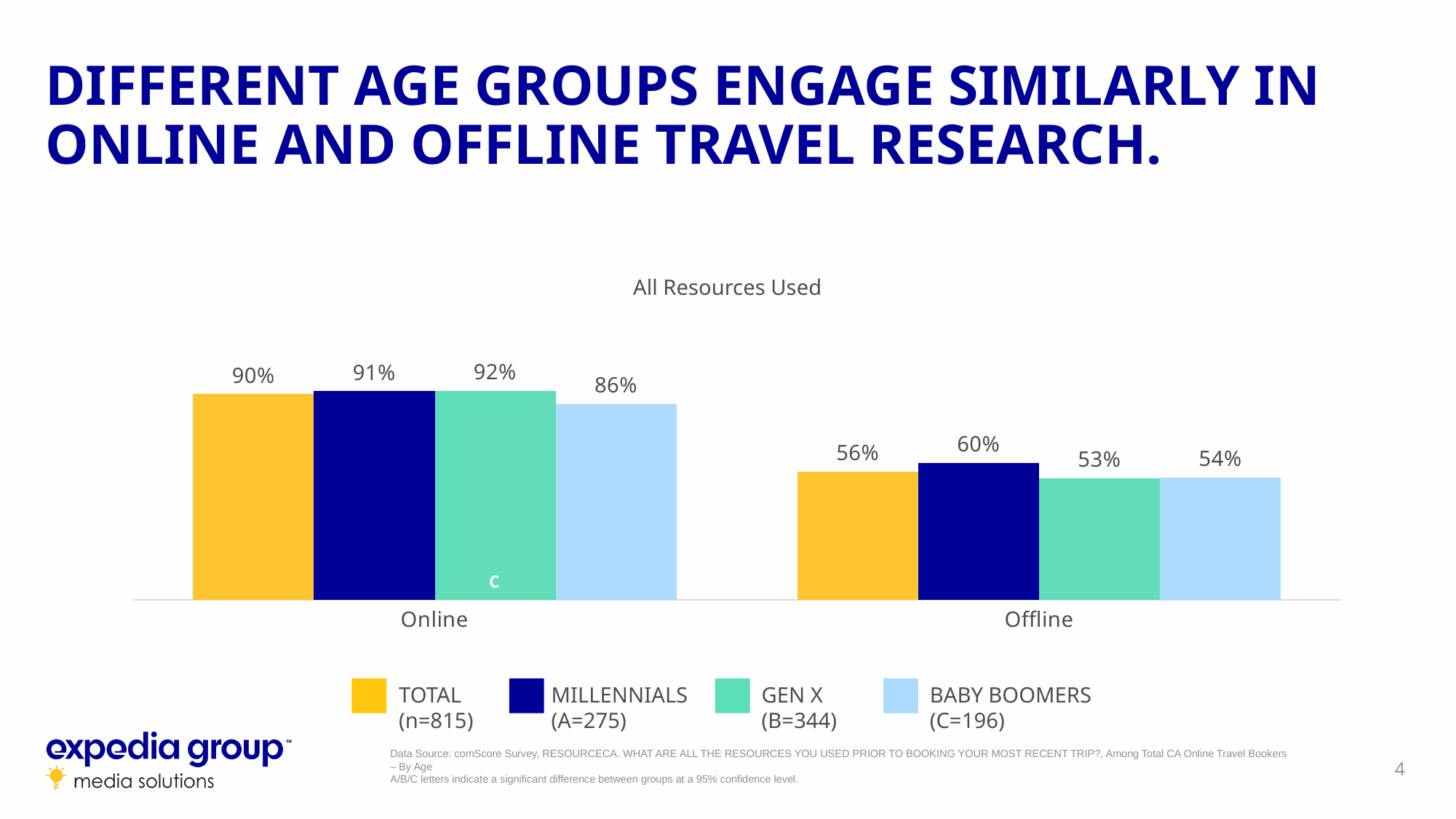
What is the value for Millennials in the Offline category? 60% What is the difference between the Gen X value for Online and the Gen X value for Offline? 39% Which is larger: the Total value for Online or the Total value for Offline? Online What kind of chart is shown on the slide? Bar chart How many categories are shown on the x axis? 2 Which series has the lowest value in the Online category? Baby Boomers Which series has the highest value in the Offline category? Millennials What is the value for Total in the Online category? 90% What is the value for Gen X in the Online category? 92% What is the value for Baby Boomers in the Offline category? 54% How many series does the legend list? 4 What is the title of the chart? All Resources Used